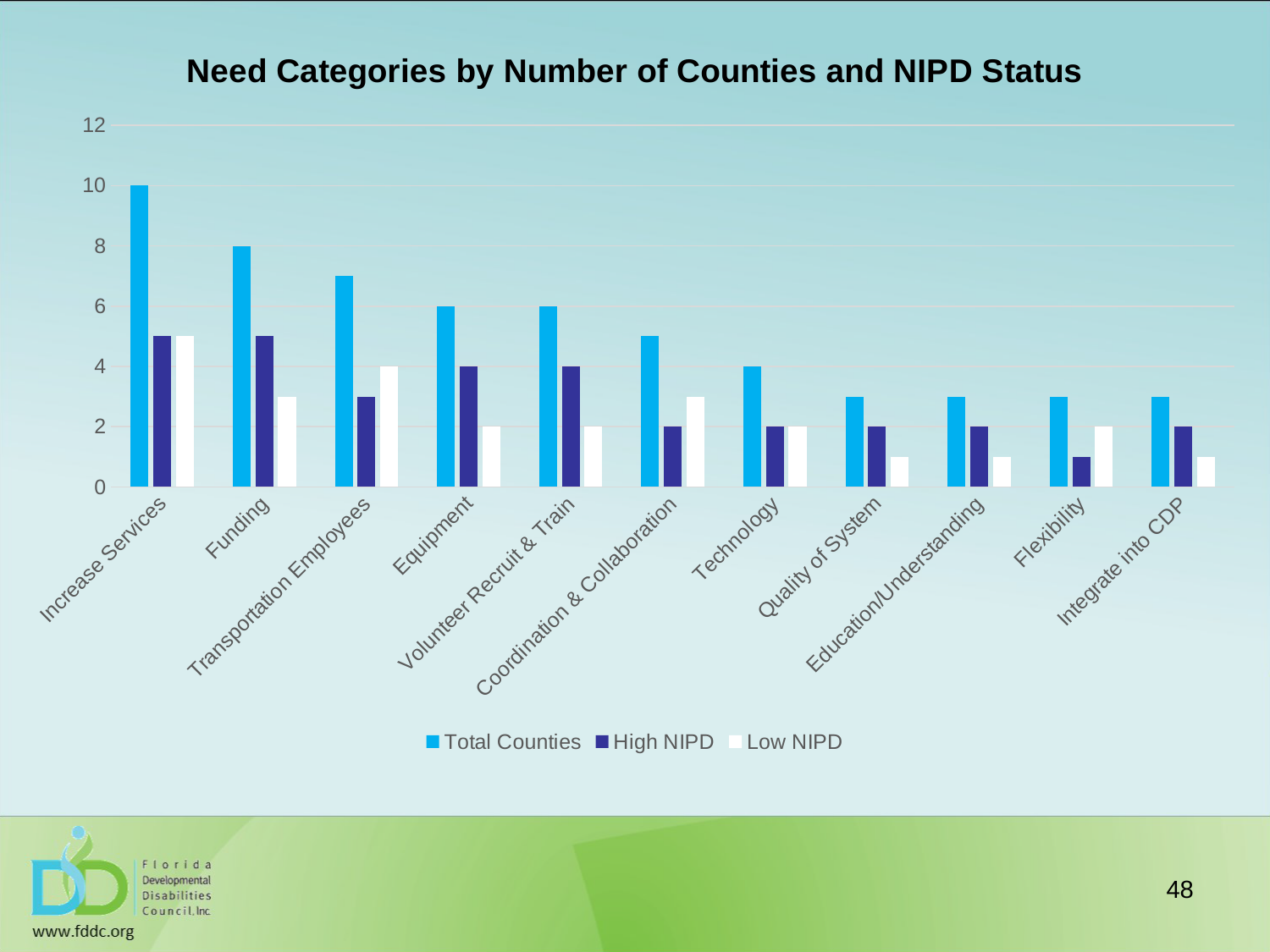
Which has a larger Total Counties value, Funding or Equipment? Funding What is the Total Counties value for Increase Services? 10 What is the High NIPD value for Equipment? 4 What type of chart is shown on the slide? bar chart How many series does the legend list? 3 What is the difference between the Total Counties values for Increase Services and Funding? 2 What is the Total Counties value for Funding? 8 How many need categories are shown on the x axis? 11 Which category has the highest Total Counties value? Increase Services What is the title of the chart? Need Categories by Number of Counties and NIPD Status Do the Total Counties values generally rise or fall from left to right along the x axis? fall Is the Total Counties value for Transportation Employees greater or less than 6? greater